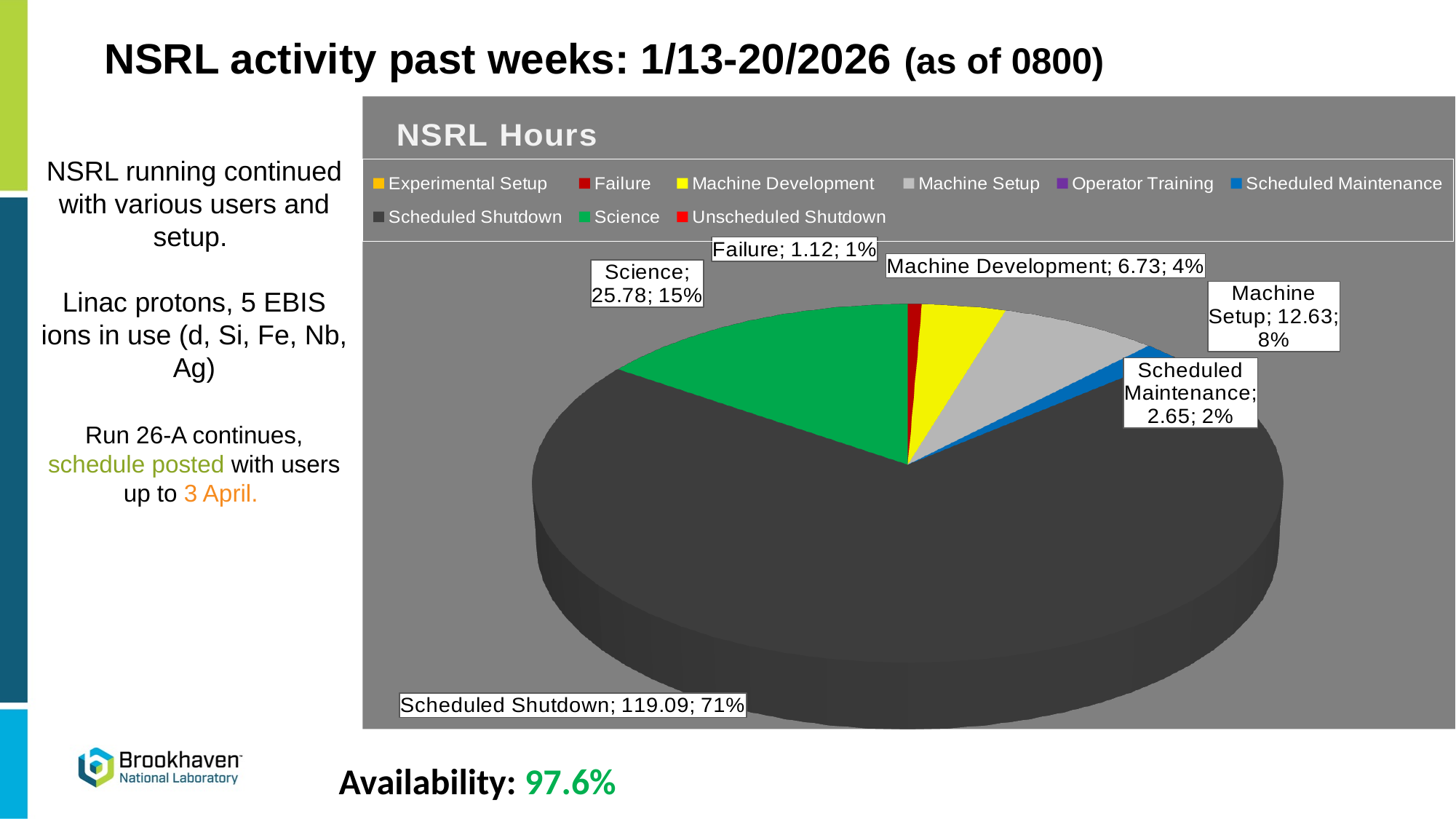
What type of chart is shown on the slide? pie chart How many slices in the pie have data labels? 6 What is the title of the chart? NSRL Hours How many hours are shown for Scheduled Shutdown? 119.09 What is the difference in hours between Science and Machine Setup? 13.15 Which labeled category has the smallest slice of the pie? Failure How many hours are shown for Machine Setup? 12.63 What percentage of the pie does Science account for? 15% How many categories does the legend list? 9 Which category has the largest slice of the pie? Scheduled Shutdown What percentage share is labeled for Scheduled Maintenance? 2% Which has more hours, Machine Development or Scheduled Maintenance? Machine Development